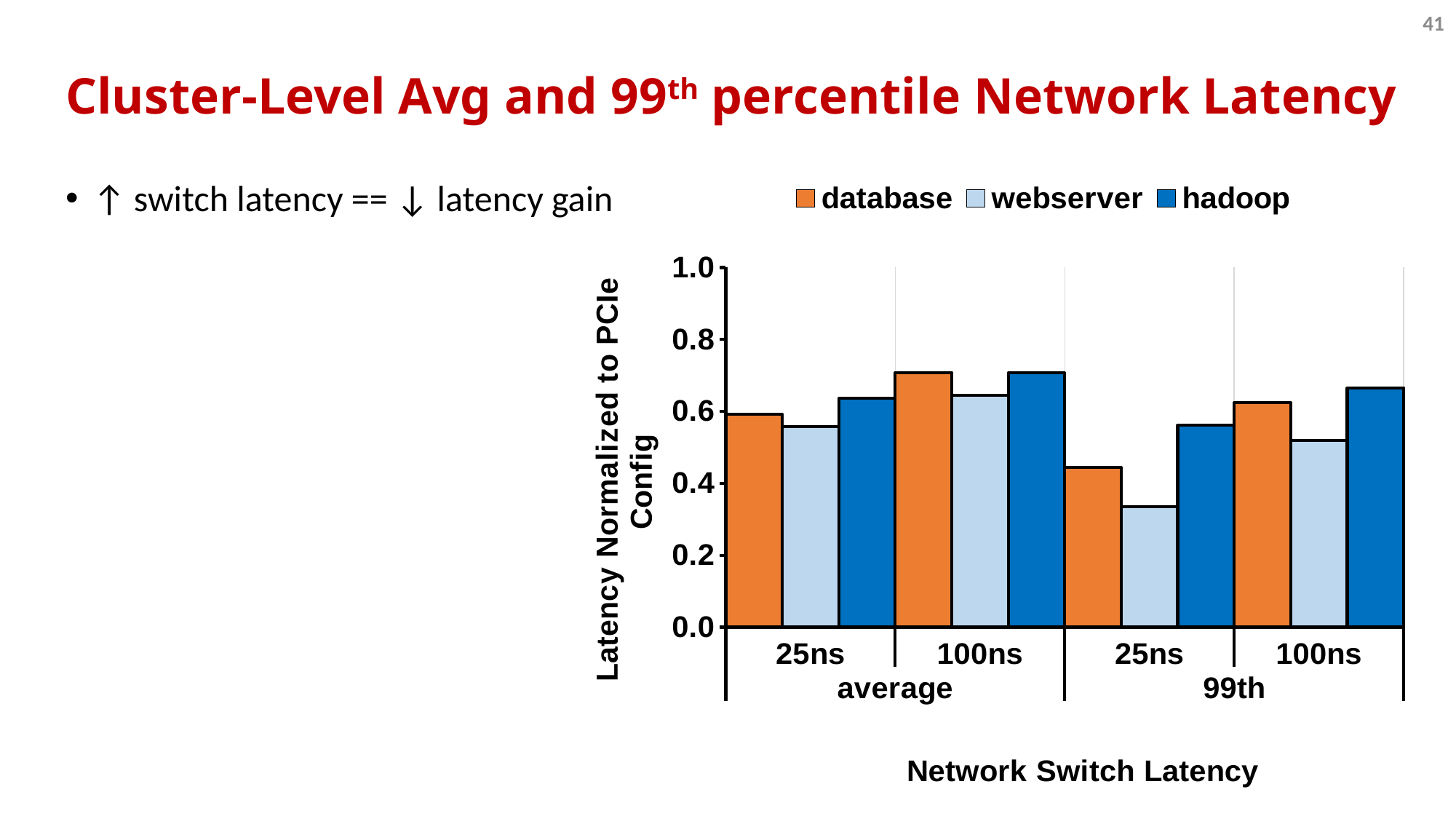
What kind of chart is shown on the slide? bar chart Is the value for database at 25ns in the 99th group greater or less than 0.6? less Is the value for webserver at 100ns in the 99th group greater or less than 0.4? greater At 100ns in the 99th group, which is larger: database or webserver? database How many series does the legend list? 3 Is the value for webserver at 25ns in the 99th group greater or less than 0.4? less For the webserver series in the 99th group, does the value rise or fall from 25ns to 100ns? rise Which series has the lowest value at 25ns in the 99th group? webserver Which series has the highest value at 25ns in the average group? hadoop What is the title of the x axis? Network Switch Latency How many bars are plotted in the chart? 12